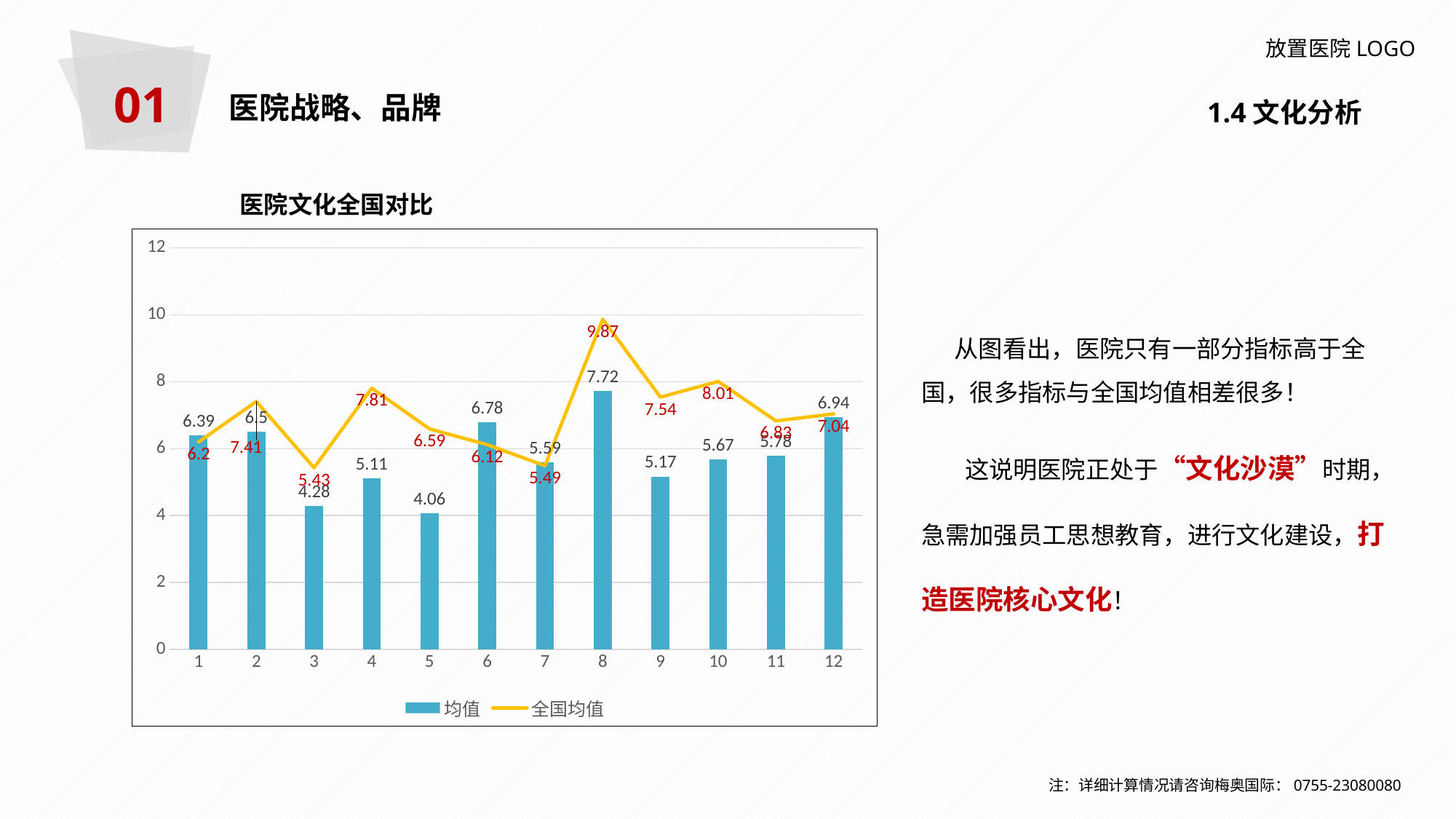
Which category has the highest 均值 bar? 8 How many categories are shown on the x axis? 12 What is the 全国均值 value for category 4? 7.81 For category 1, which is larger, 均值 or 全国均值? 均值 What is the 均值 value for category 5? 4.06 How many series does the legend list? 2 Does the 全国均值 line rise or fall from category 8 to category 9? Fall For category 8, what is the difference between 全国均值 and 均值? 2.15 What kind of chart is this? Combined bar and line chart Which category has the highest 全国均值 value? 8 What is the 均值 value for category 8? 7.72 Which category has the lowest 均值 bar? 5